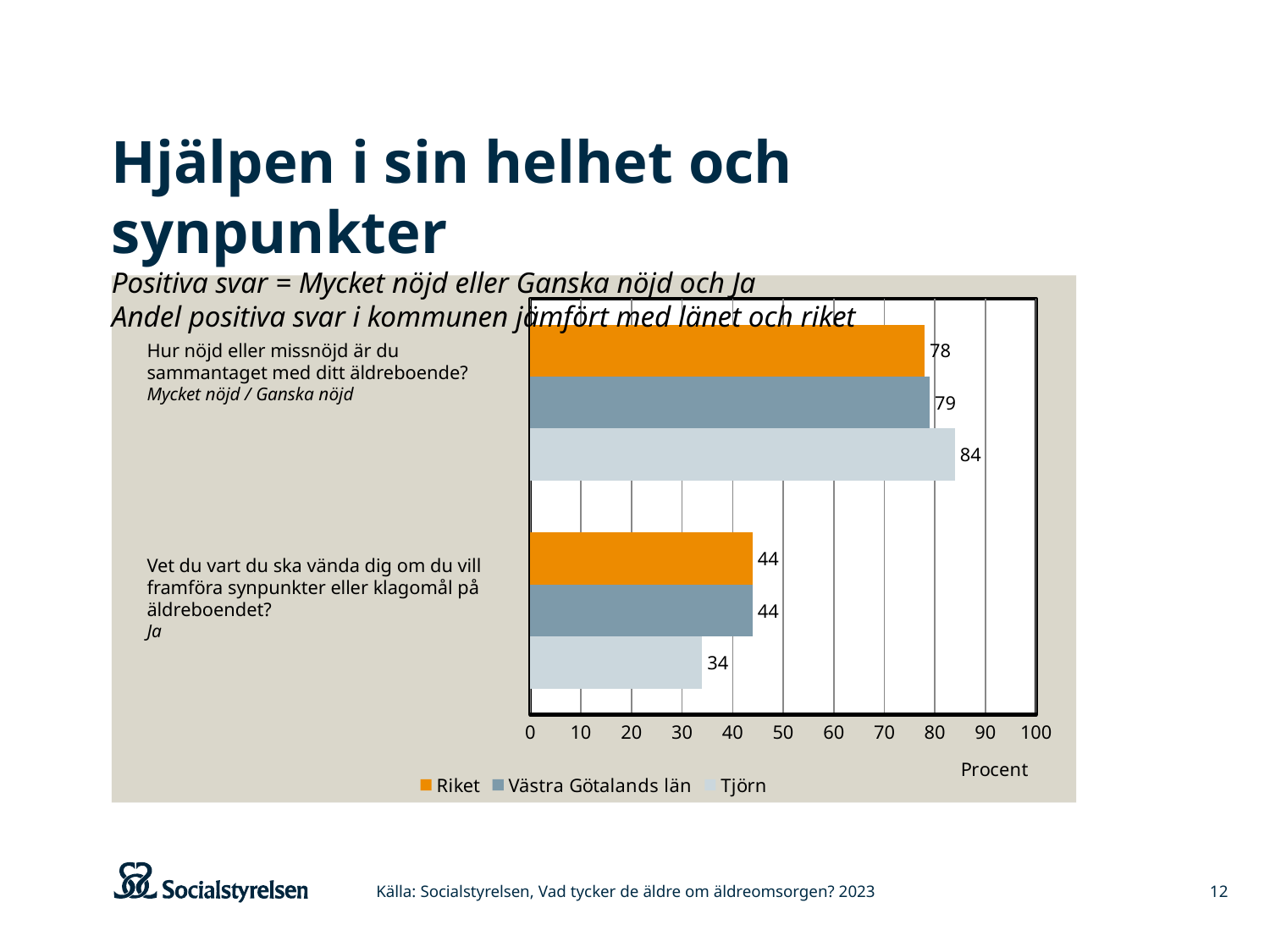
Is the value for Tjörn on the question "Vet du vart du ska vända dig om du vill framföra synpunkter eller klagomål på äldreboendet?" greater or less than 40? less Which series has the highest value on the question "Hur nöjd eller missnöjd är du sammantaget med ditt äldreboende?"? Tjörn What is the value for Riket on the question "Hur nöjd eller missnöjd är du sammantaget med ditt äldreboende?"? 78 What is the value for Tjörn on the question "Vet du vart du ska vända dig om du vill framföra synpunkter eller klagomål på äldreboendet?"? 34 How many series does the legend list? 3 What is the value for Västra Götalands län on the question "Vet du vart du ska vända dig om du vill framföra synpunkter eller klagomål på äldreboendet?"? 44 Which series has the lowest value on the question "Vet du vart du ska vända dig om du vill framföra synpunkter eller klagomål på äldreboendet?"? Tjörn What kind of chart is shown on the slide? Bar chart What is the difference between Riket and Tjörn on the question "Vet du vart du ska vända dig om du vill framföra synpunkter eller klagomål på äldreboendet?"? 10 What unit is shown on the horizontal axis of the chart? Procent What is the value for Tjörn on the question "Hur nöjd eller missnöjd är du sammantaget med ditt äldreboende?"? 84 What is the difference between Tjörn and Riket on the question "Hur nöjd eller missnöjd är du sammantaget med ditt äldreboende?"? 6